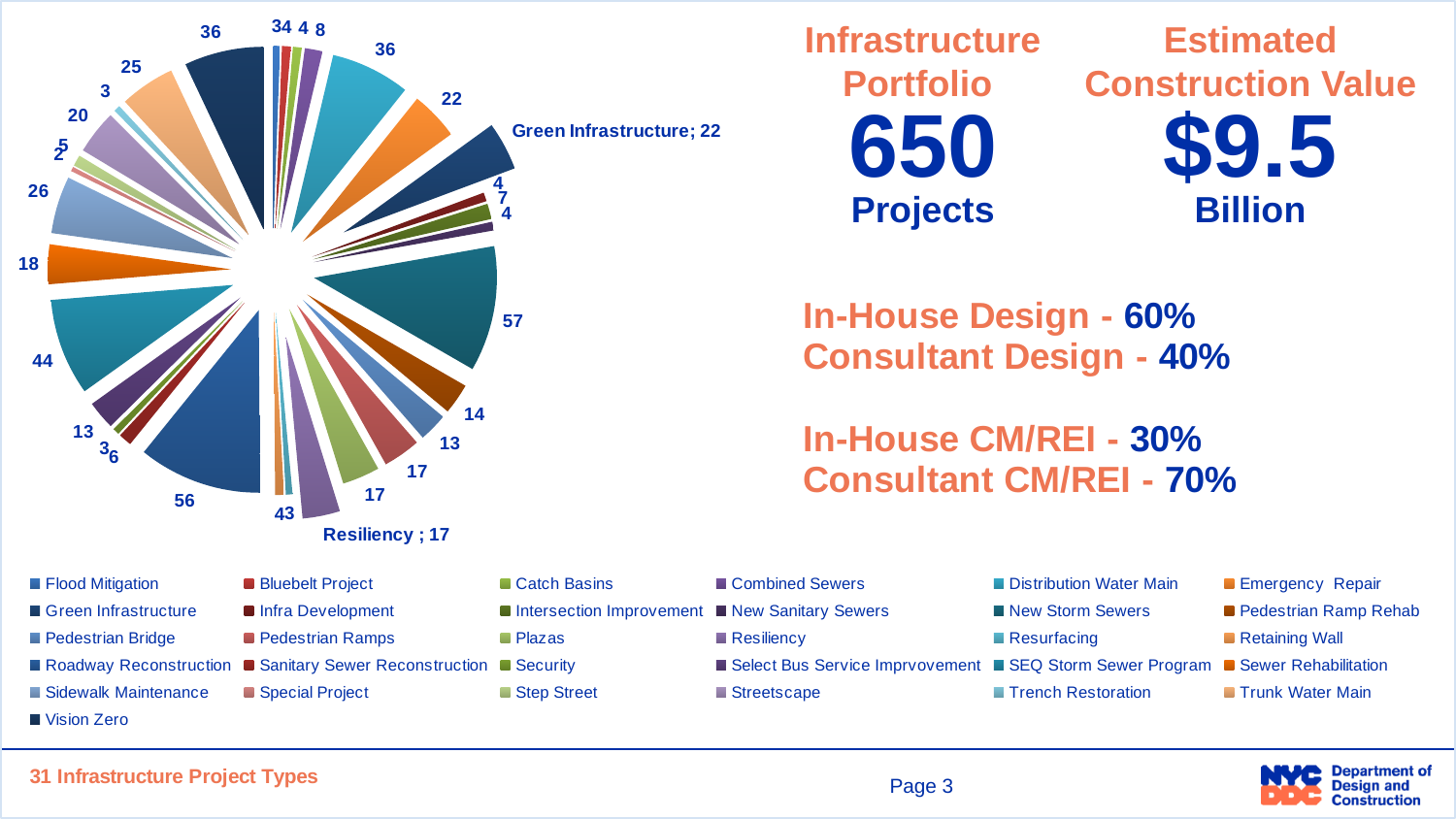
What is the first entry listed in the pie chart's legend? Flood Mitigation Is the value for Green Infrastructure in the pie chart greater or less than 20? greater How many project types (categories) does the pie chart's legend list? 31 What is the smallest value labeled on any slice of the pie chart? 2 What is the value shown for Green Infrastructure in the pie chart? 22 What is the last entry listed in the pie chart's legend? Vision Zero Which has the larger value in the pie chart, Green Infrastructure or Resiliency? Green Infrastructure What is the largest value labeled on any slice of the pie chart? 57 What is the value shown for Resiliency in the pie chart? 17 What type of chart is shown on the slide? pie chart What is the difference between the Green Infrastructure value and the Resiliency value in the pie chart? 5